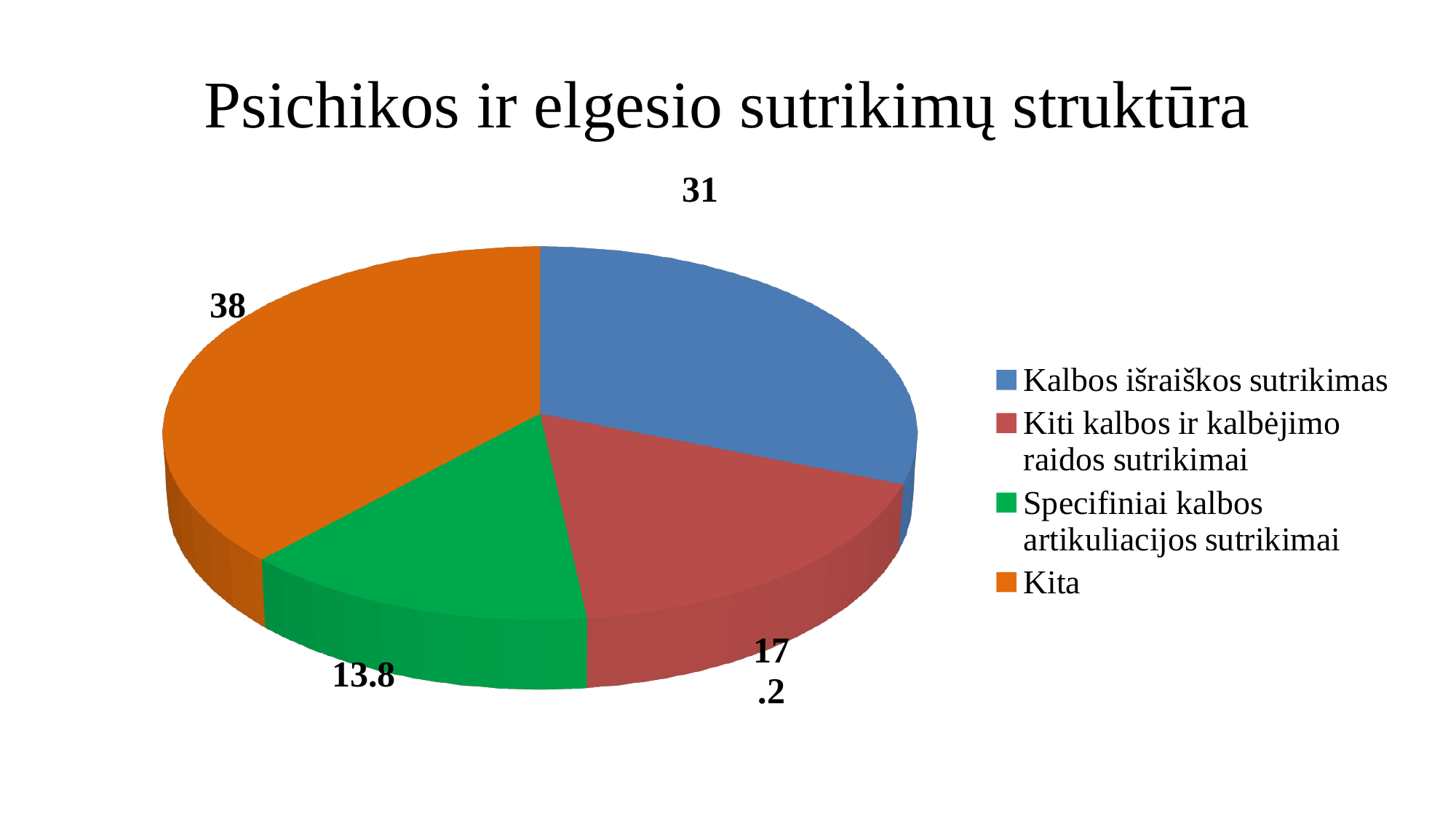
Which category has the smallest slice of the pie? Specifiniai kalbos artikuliacijos sutrikimai What is the difference between the values for Kiti kalbos ir kalbėjimo raidos sutrikimai and Specifiniai kalbos artikuliacijos sutrikimai? 3.4 What is the difference between the values for Kita and Kalbos išraiškos sutrikimas? 7 What is the title of the chart on the slide? Psichikos ir elgesio sutrikimų struktūra What is the value shown for Kalbos išraiškos sutrikimas? 31 How many categories are shown in the pie chart? 4 Which category has the largest slice of the pie? Kita What is the value shown for Kiti kalbos ir kalbėjimo raidos sutrikimai? 17.2 What kind of chart is shown on the slide? Pie chart What is the value shown for Kita in the pie chart? 38 Which is larger: the value for Kalbos išraiškos sutrikimas or the value for Kiti kalbos ir kalbėjimo raidos sutrikimai? Kalbos išraiškos sutrikimas What is the value shown for Specifiniai kalbos artikuliacijos sutrikimai? 13.8